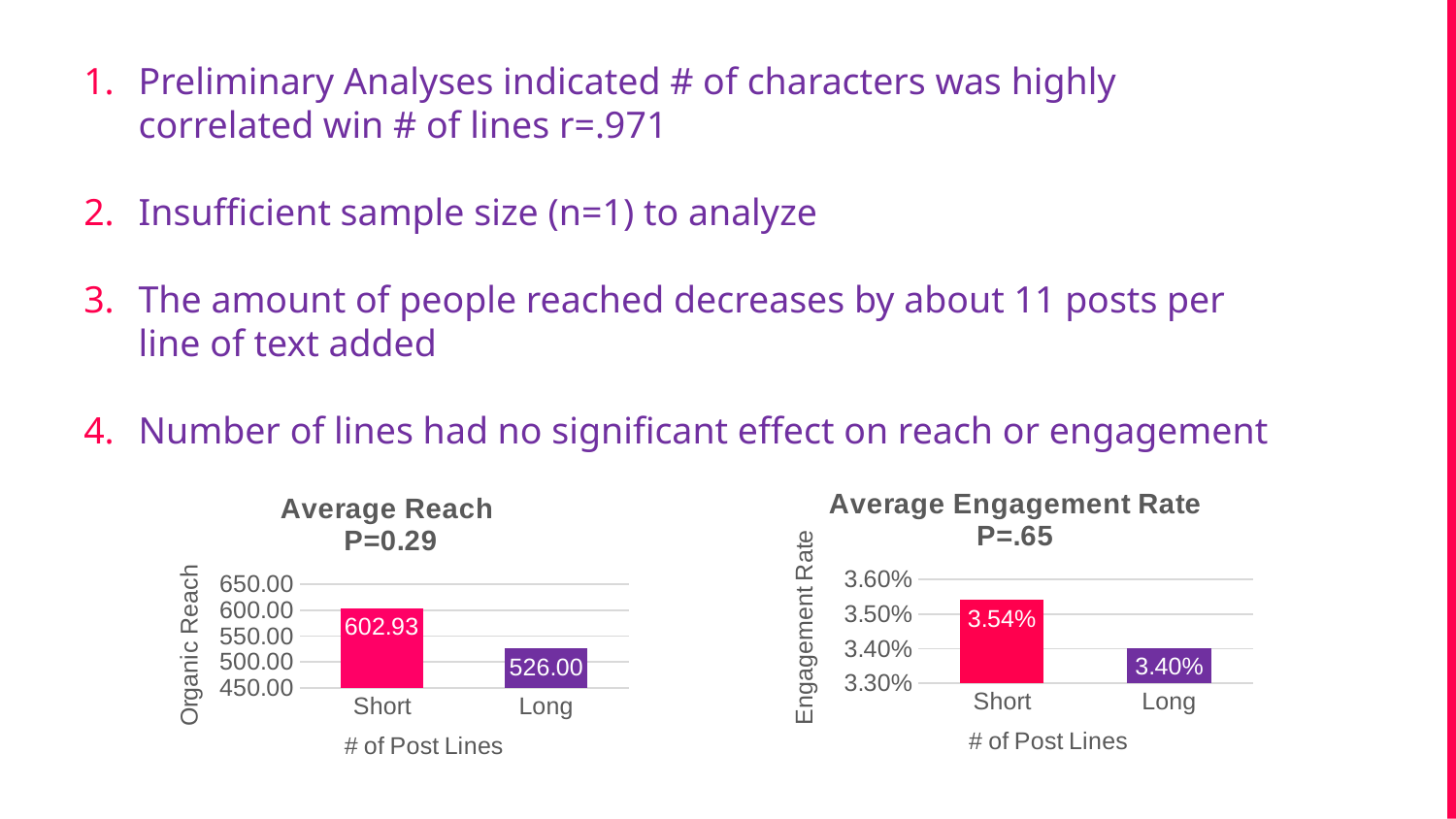
What kind of chart is the Average Reach chart? bar chart In the Average Reach chart, is the value for Long greater or less than 550.00? less In the Average Reach chart, what is the value for Long? 526.00 In the Average Engagement Rate chart, what is the difference between the Short and Long values? 0.14% In the Average Engagement Rate chart, what is the value for Short? 3.54% How many categories are shown in the Average Engagement Rate chart? 2 In the Average Engagement Rate chart, which category has the lower value? Long In the Average Reach chart, what is the difference between the Short and Long values? 76.93 In the Average Reach chart, which category has the higher value? Short What is the x-axis label of the Average Engagement Rate chart? # of Post Lines In the Average Reach chart, what is the value for Short? 602.93 In the Average Engagement Rate chart, what is the value for Long? 3.40%